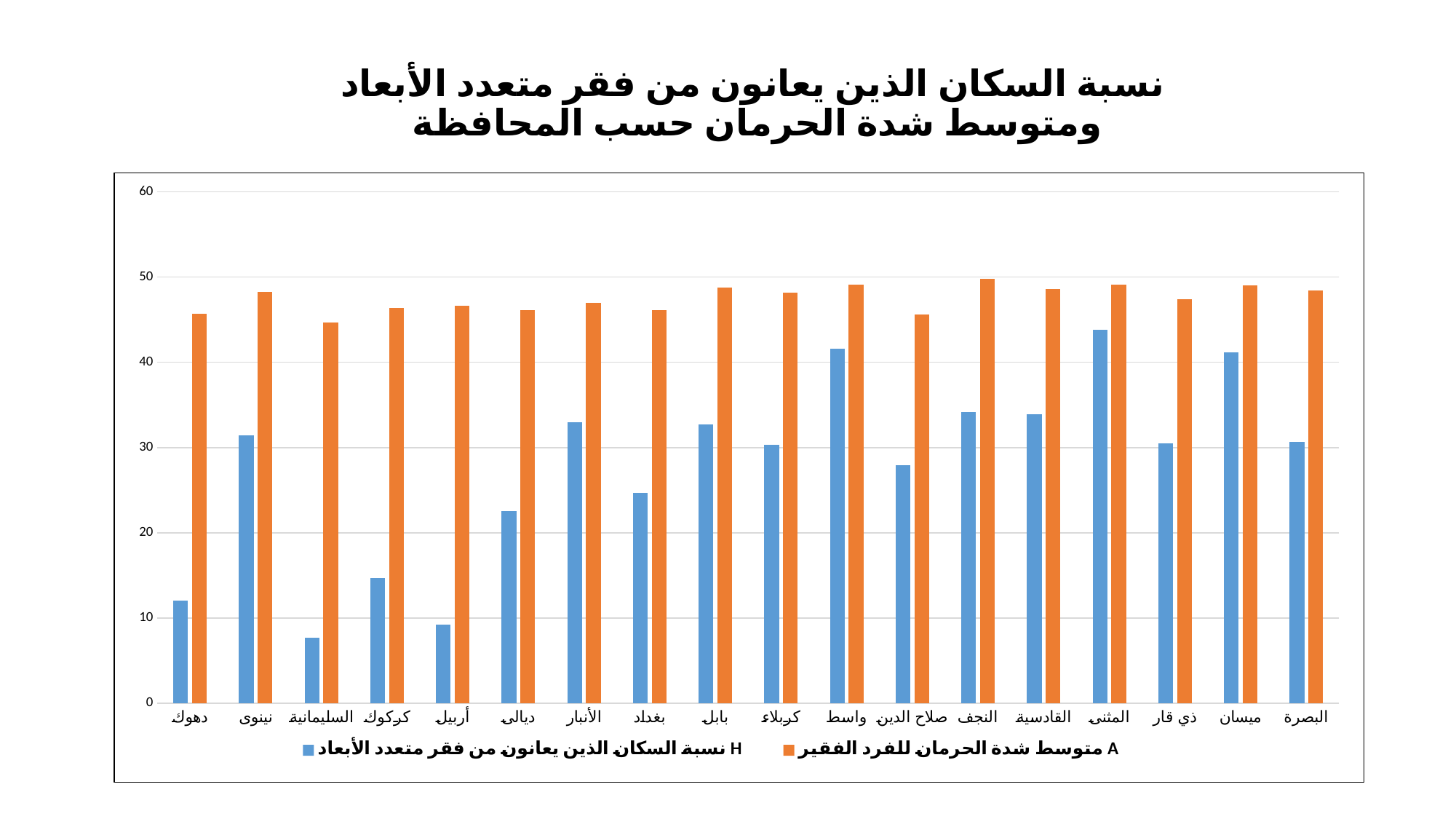
Is the blue (H) value for أربيل greater or less than 10? less How many governorates (categories) are shown on the x axis? 18 Is the blue (H) value for المثنى greater or less than 40? greater Which has the larger blue (H) value, دهوك or نينوى? نينوى For دهوك, which series has the larger value, the blue (H) or the orange (A)? orange (A) What kind of chart is shown on the slide? bar chart How many series does the legend list? 2 Which governorate has the lowest value for the blue series (H نسبة السكان الذين يعانون من فقر متعدد الأبعاد)? السليمانية Is the blue (H) value for السليمانية greater or less than 10? less Which colour represents the series A متوسط شدة الحرمان للفرد الفقير? orange